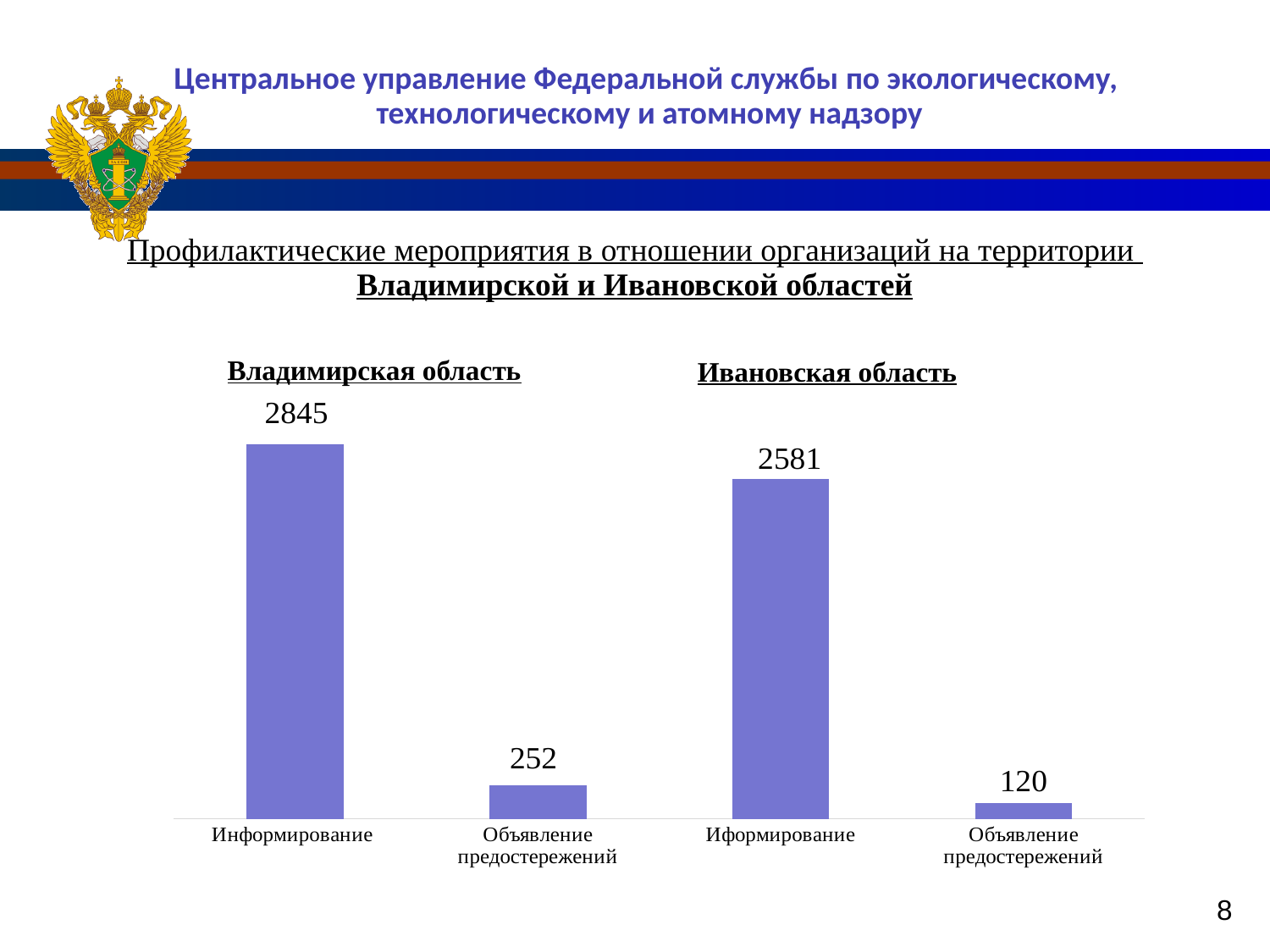
What is the value for Объявление предостережений in Ивановская область? 120 What is the value for Иформирование in Ивановская область? 2581 What is the difference between Информирование in Владимирская область and Иформирование in Ивановская область? 264 What is the value for Объявление предостережений in Владимирская область? 252 How many bars are plotted on the chart? 4 What type of chart is shown on the slide? Bar chart Which bar has the highest value on the chart? Информирование (Владимирская область) What is the difference between Объявление предостережений in Владимирская область and in Ивановская область? 132 What is the total of Информирование and Объявление предостережений for Владимирская область? 3097 Which bar has the lowest value on the chart? Объявление предостережений (Ивановская область) What is the value for Информирование in Владимирская область? 2845 Which is larger: Объявление предостережений in Владимирская область or in Ивановская область? Владимирская область